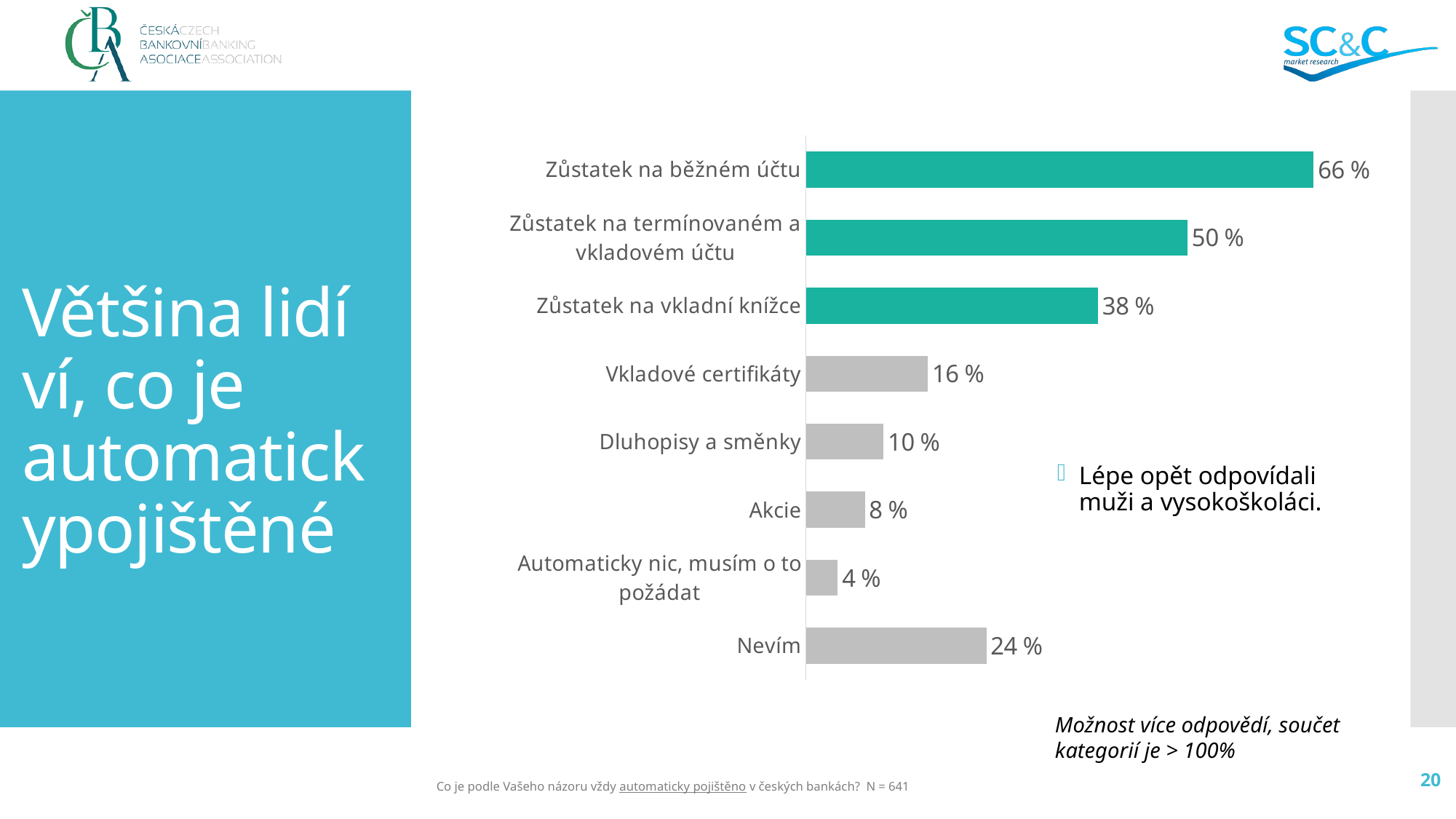
What is the difference between the values for "Zůstatek na běžném účtu" and "Zůstatek na termínovaném a vkladovém účtu"? 16 % What kind of chart is shown on the slide? Bar chart How many bars are coloured teal (green) rather than grey? 3 What is the difference between the values for "Dluhopisy a směnky" and "Akcie"? 2 % What is the value for "Zůstatek na běžném účtu"? 66 % How many categories are shown in the chart? 8 Which category has the lowest value? Automaticky nic, musím o to požádat What is the value for "Automaticky nic, musím o to požádat"? 4 % What is the value for "Nevím"? 24 % Which is larger, the value for "Vkladové certifikáty" or the value for "Nevím"? Nevím Which category has the highest value? Zůstatek na běžném účtu What is the value for "Zůstatek na vkladní knížce"? 38 %